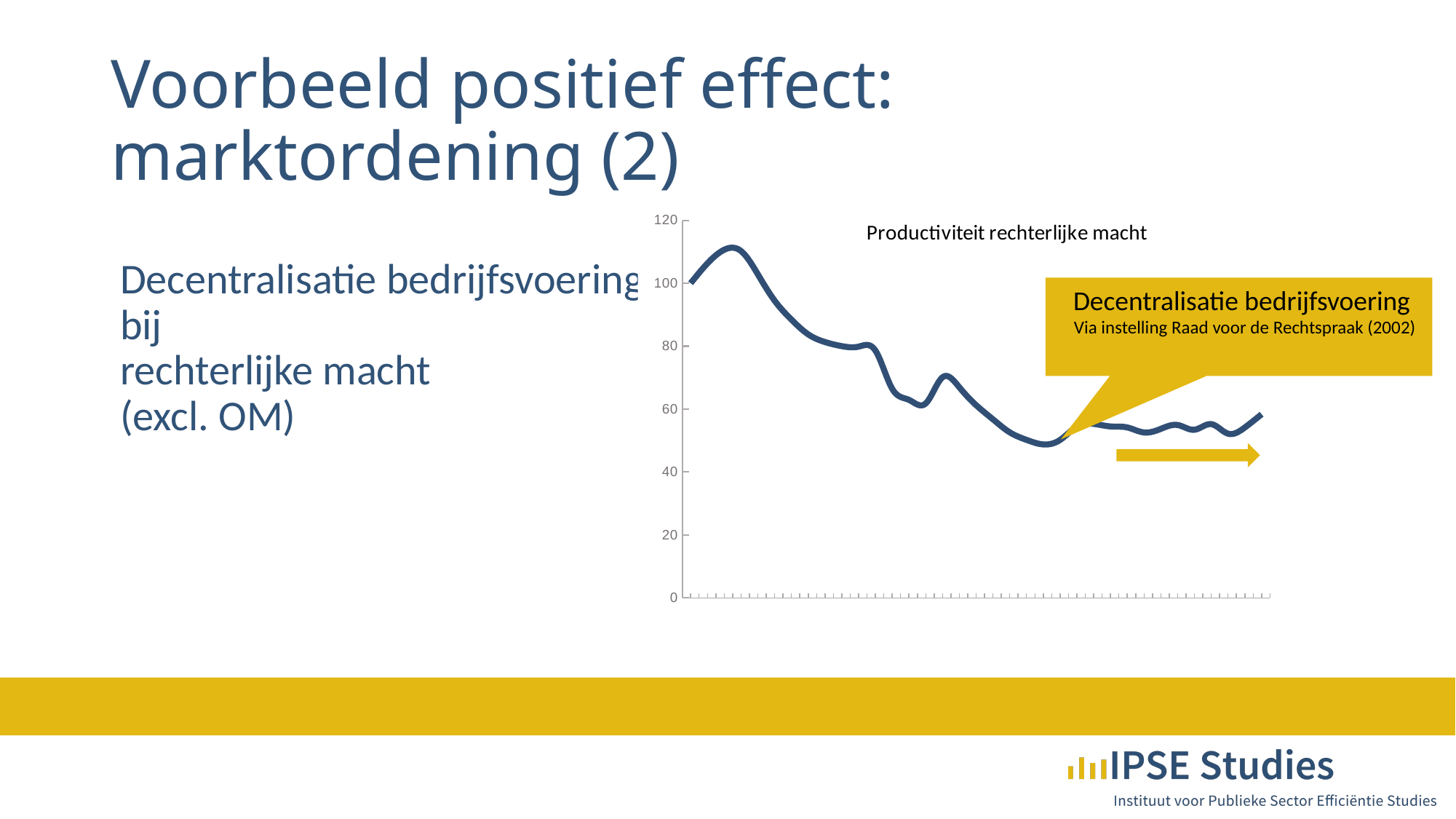
Is the value at the left end of the line greater or less than 80? greater What kind of chart is shown on the slide? line chart What is the highest value shown on the vertical axis? 120 Is the lowest point of the line greater or less than 60? less What is the title of the chart? Productiviteit rechterlijke macht Is the lowest point of the line greater or less than 40? greater Does the line in the chart overall rise or fall from left to right? fall How many lines (series) are plotted in the chart? 1 Which is higher: the value at the left end of the line or the value at the right end? the left end